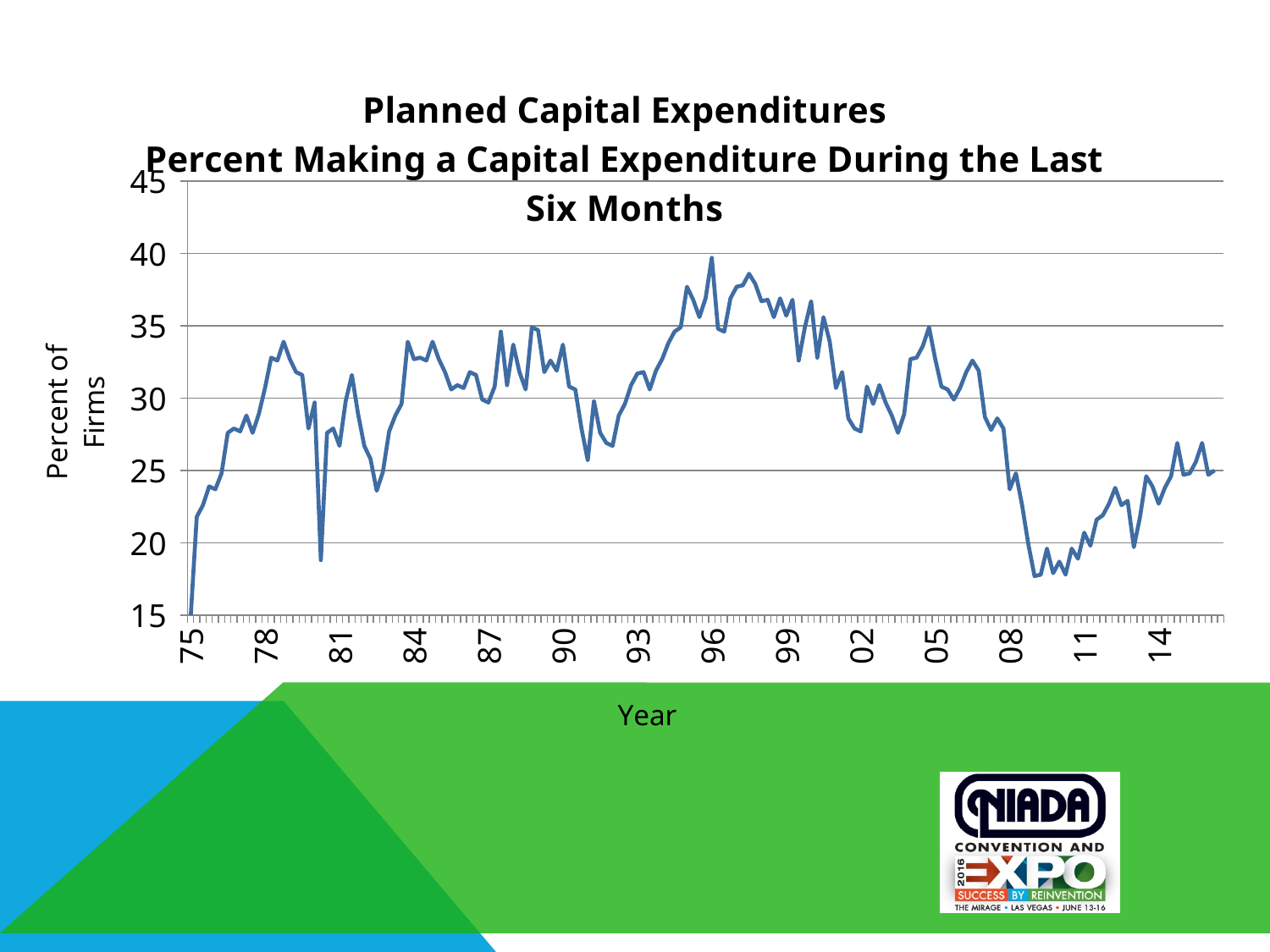
Is the value of the line around 1984 greater or less than 30? greater Around which year label does the line reach its highest value? 96 How many data series (lines) are plotted on the chart? 1 Is the peak value of the line around 1996 greater or less than 35? greater Is the value of the line around 2014 greater or less than 30? less What is the title of the chart? Planned Capital Expenditures Percent Making a Capital Expenditure During the Last Six Months What is the label on the vertical axis of the chart? Percent of Firms Does the line rise or fall between the 08 and 09 year marks? fall Does the line generally rise or fall from 2009 to 2014? rise What kind of chart is shown on the slide? line chart How many year labels are shown along the x axis? 14